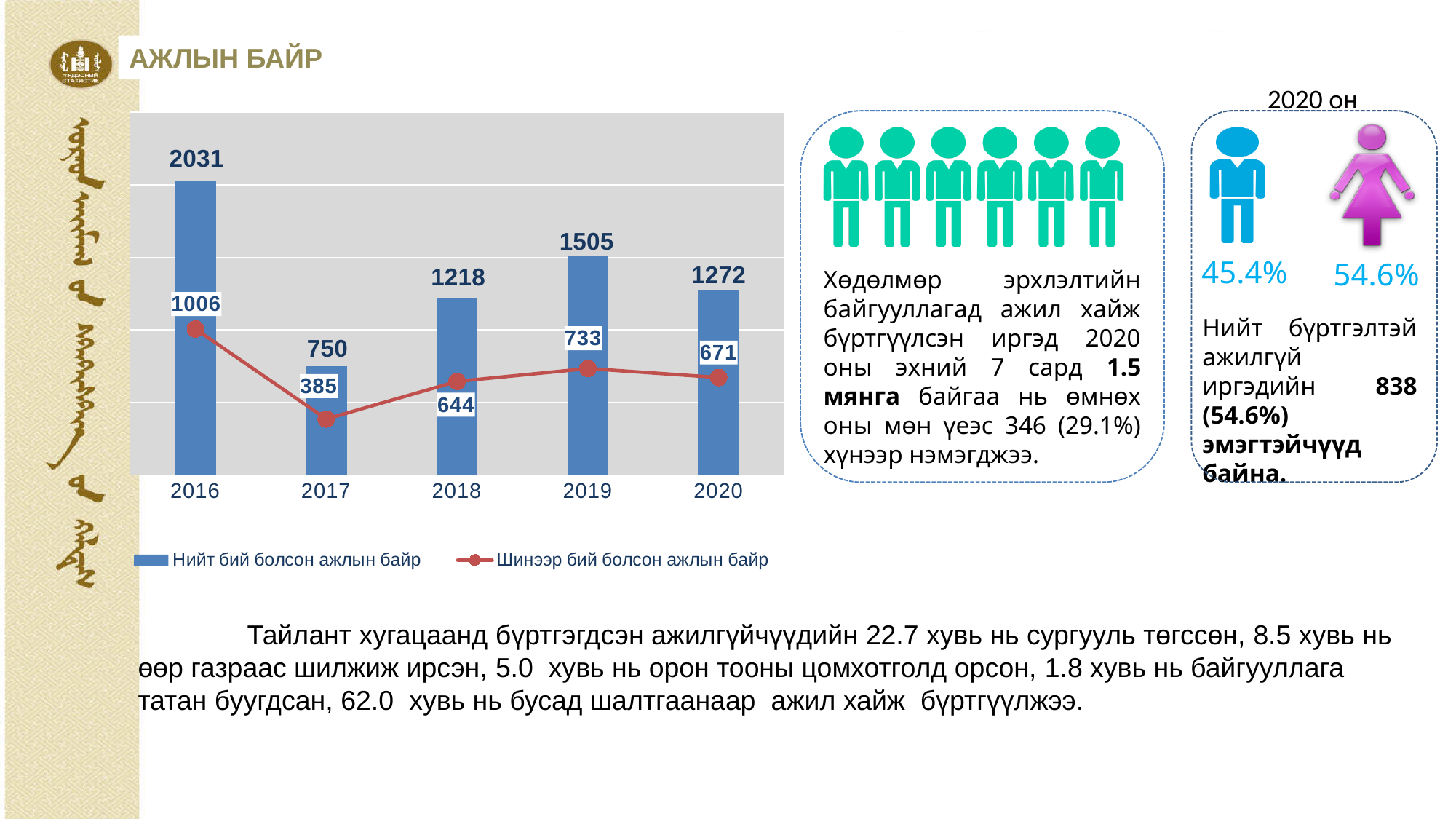
Which year has the highest value for "Нийт бий болсон ажлын байр"? 2016 Which is larger: "Шинээр бий болсон ажлын байр" in 2019 or in 2020? 2019 Which year has the lowest value for "Шинээр бий болсон ажлын байр"? 2017 Which series is shown as a red line with markers in the chart? Шинээр бий болсон ажлын байр What is the difference between "Нийт бий болсон ажлын байр" in 2019 and 2020? 233 What is the value of "Нийт бий болсон ажлын байр" for 2016? 2031 Does "Нийт бий болсон ажлын байр" rise or fall from 2016 to 2017? fall How many series does the chart legend list? 2 What kind of chart is used to show "Нийт бий болсон ажлын байр"? bar chart What is the value of "Шинээр бий болсон ажлын байр" for 2018? 644 What is the value of "Нийт бий болсон ажлын байр" for 2020? 1272 How many years are shown on the x axis of the chart? 5